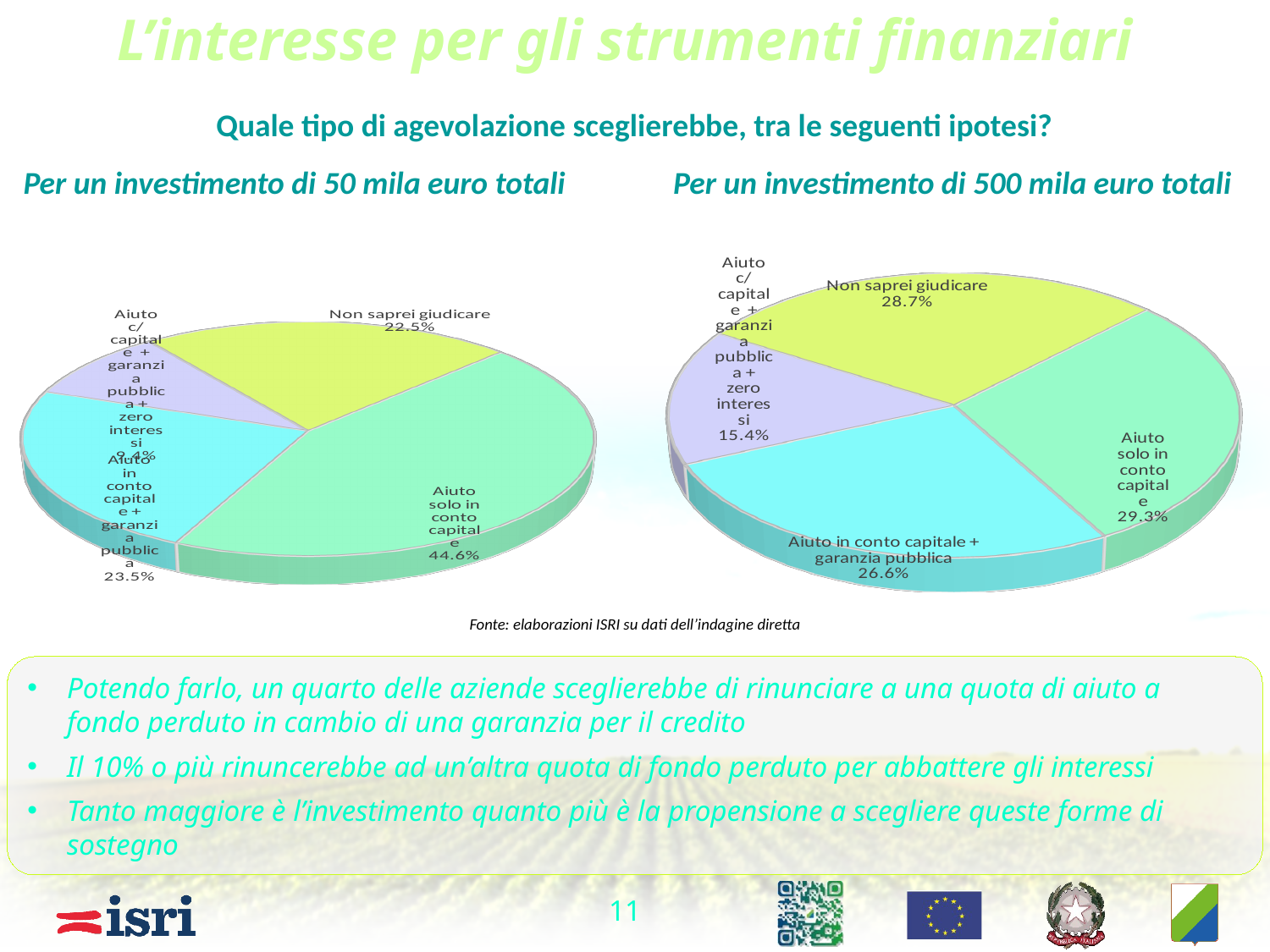
What type of chart is used for the investment of 50 mila euro totali? Pie chart In the pie chart for an investment of 50 mila euro totali, what share is 'Aiuto in conto capitale + garanzia pubblica'? 23.5% In the pie chart for an investment of 50 mila euro totali, what share is 'Non saprei giudicare'? 22.5% In the pie chart for an investment of 500 mila euro totali, what share is 'Aiuto in conto capitale + garanzia pubblica'? 26.6% In the pie chart for an investment of 50 mila euro totali, which option has the largest share? Aiuto solo in conto capitale In the pie chart for an investment of 500 mila euro totali, which option has the smallest share? Aiuto c/capitale + garanzia pubblica + zero interessi In the pie chart for an investment of 500 mila euro totali, what is the difference between 'Aiuto solo in conto capitale' and 'Aiuto c/capitale + garanzia pubblica + zero interessi'? 13.9% How many slices does the pie chart for an investment of 500 mila euro totali have? 4 In the pie chart for an investment of 50 mila euro totali, what share is 'Aiuto solo in conto capitale'? 44.6% In the pie chart for an investment of 500 mila euro totali, what share is 'Aiuto c/capitale + garanzia pubblica + zero interessi'? 15.4% Which is larger: 'Aiuto solo in conto capitale' in the 50 mila euro chart or in the 500 mila euro chart? 50 mila euro chart In the pie chart for an investment of 500 mila euro totali, what share is 'Non saprei giudicare'? 28.7%